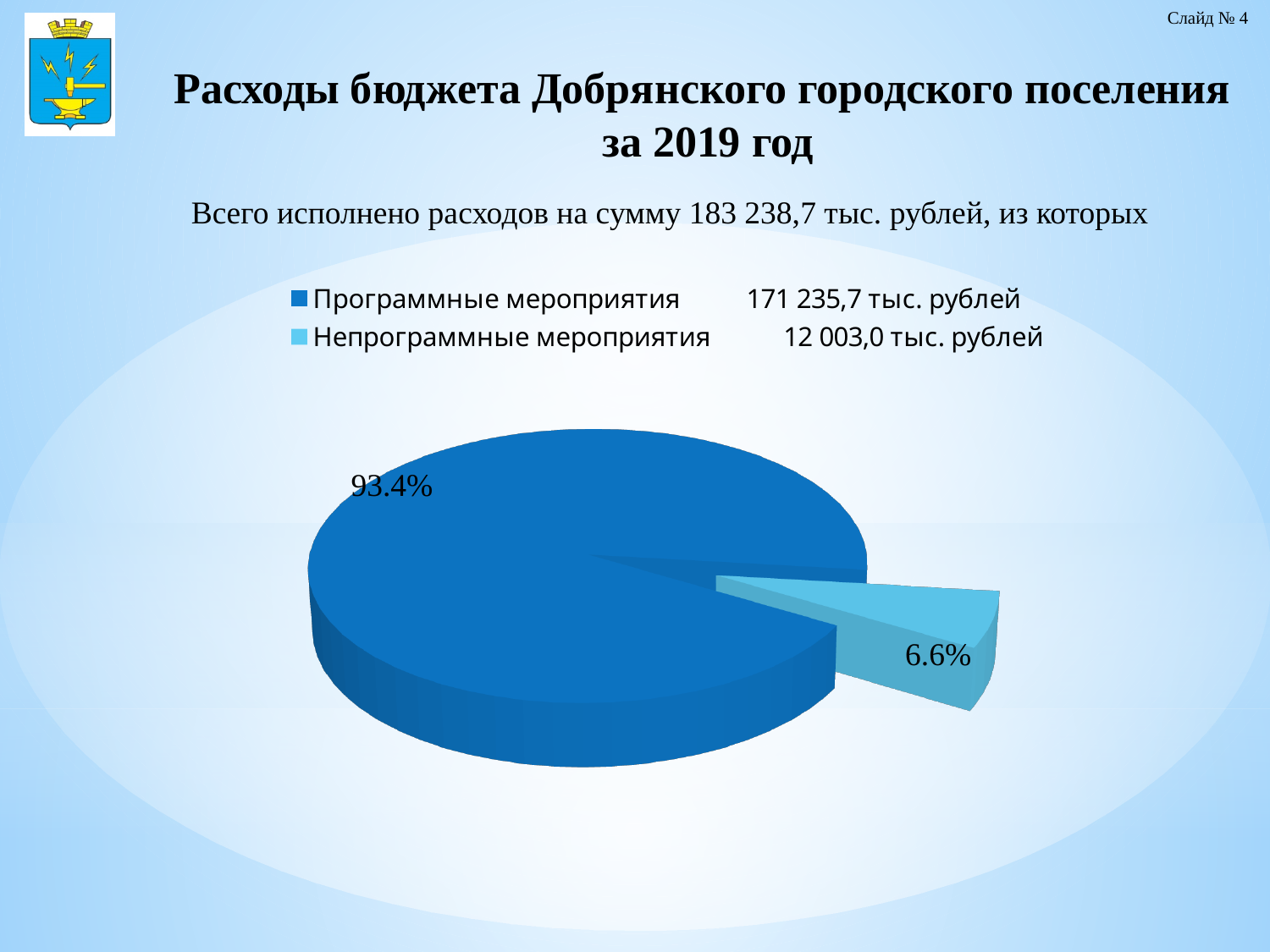
How many slices does the pie chart have? 2 What is the title of the slide containing the chart? Расходы бюджета Добрянского городского поселения за 2019 год What kind of chart is shown on the slide? pie chart How many entries does the legend list? 2 Which is larger, the share for Программные мероприятия or for Непрограммные мероприятия? Программные мероприятия Which category has the smallest slice of the pie? Непрограммные мероприятия What share of the pie does Программные мероприятия take? 93.4% Which category has the largest slice of the pie? Программные мероприятия What is the difference in percentage points between the two slices of the pie? 86.8% What share of the pie does Непрограммные мероприятия take? 6.6% What is the value shown in the legend for Программные мероприятия? 171 235,7 тыс. рублей What is the value shown in the legend for Непрограммные мероприятия? 12 003,0 тыс. рублей